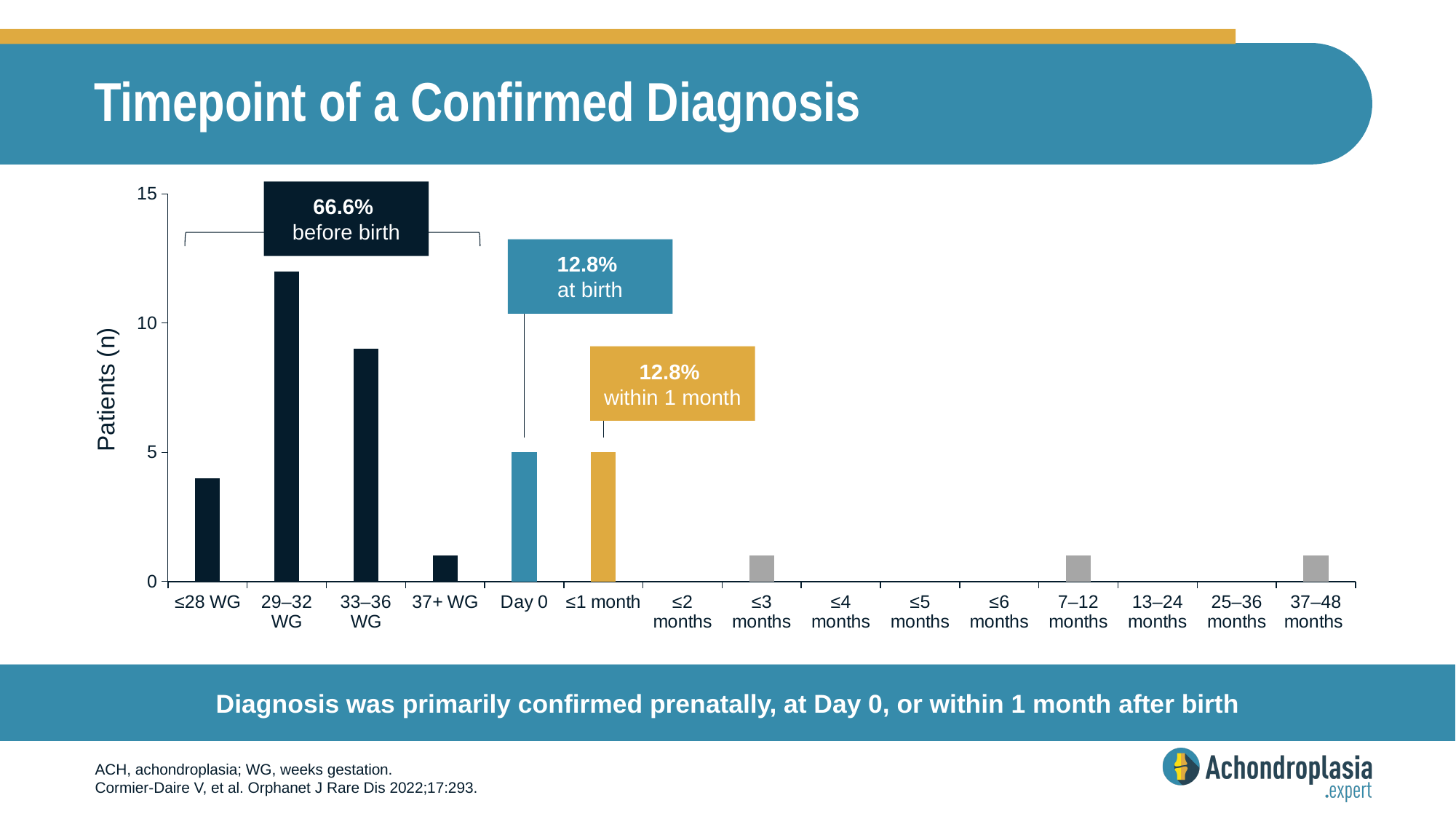
Is the number of patients for ≤28 WG greater or less than 5? less How many patients were diagnosed at Day 0? 5 What is the y-axis label of the chart? Patients (n) Is the number of patients for 29–32 WG greater or less than 10? greater What percentage of patients had a confirmed diagnosis before birth, according to the annotation? 66.6% Which timepoint category has the highest number of patients? 29–32 WG Is the number of patients for 33–36 WG greater or less than 10? less Which has more patients, 29–32 WG or 33–36 WG? 29–32 WG Which has more patients, ≤28 WG or 37+ WG? ≤28 WG What kind of chart is shown on the slide? bar chart How many patients were diagnosed at ≤1 month? 5 How many timepoint categories are shown on the x axis? 15